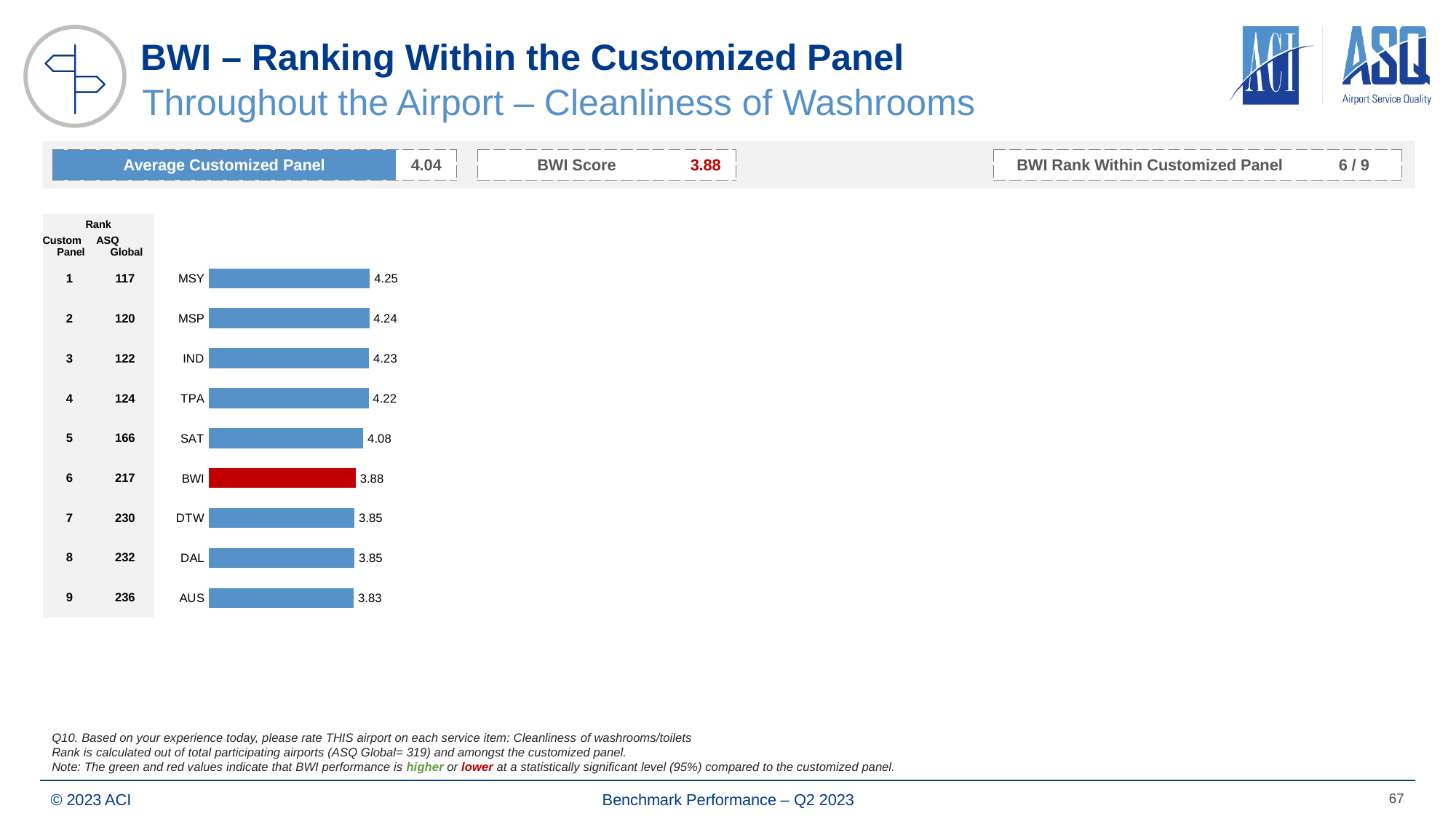
How many airports are shown in the chart? 9 What is the value for AUS? 3.83 What is the value for MSY? 4.25 Which airport has the lowest value? AUS What is the difference between the values for SAT and AUS? 0.25 Which has a larger value, TPA or DTW? TPA What kind of chart is shown on the slide? Bar chart Which airport has the highest value? MSY What is the difference between the values for MSY and BWI? 0.37 What is the value for BWI? 3.88 What is the value for SAT? 4.08 Which bar is coloured red in the chart? BWI